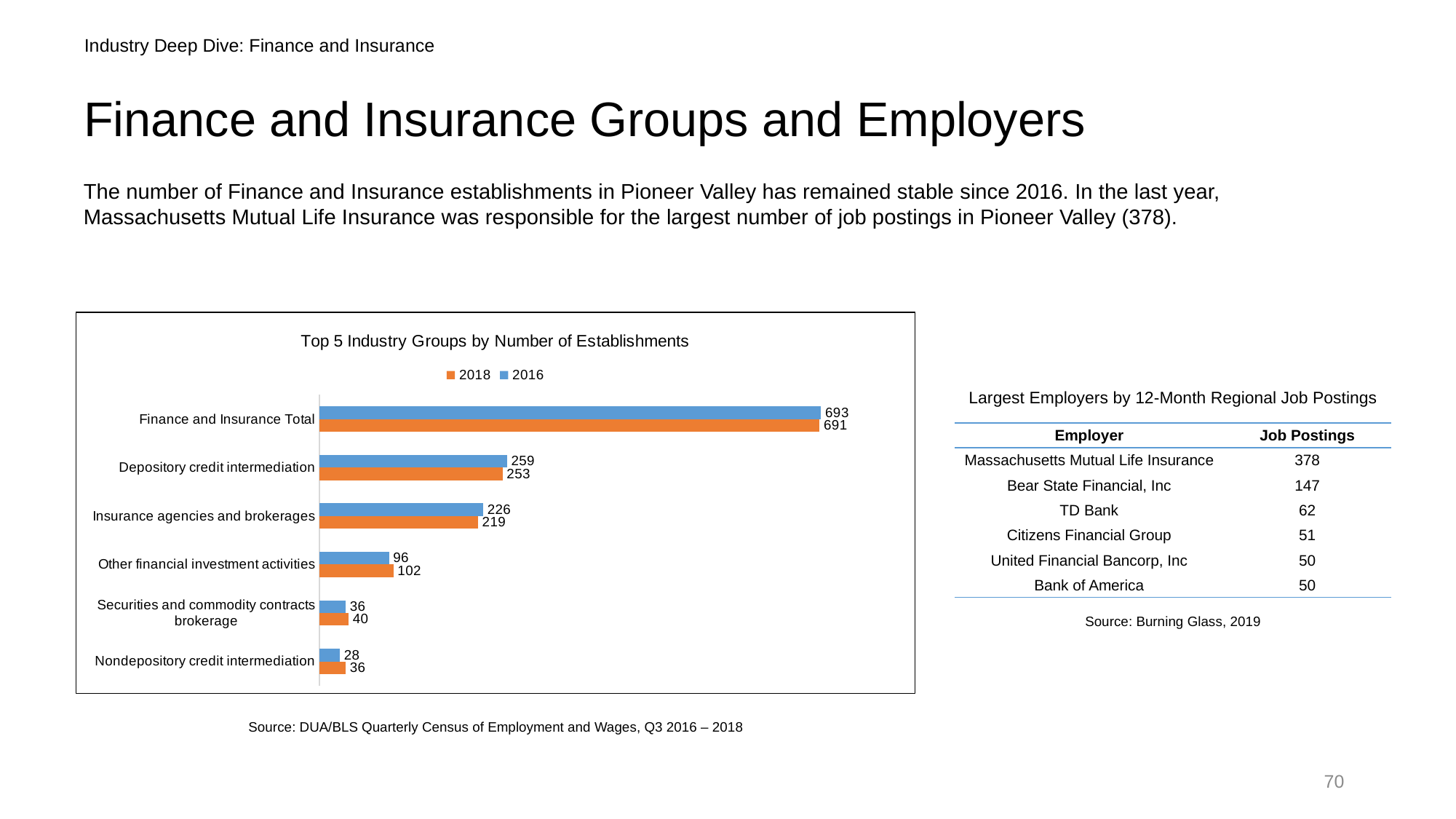
What is the 2016 value for Insurance agencies and brokerages? 226 How many series does the legend of the chart list? 2 Which category has the lowest 2016 value? Nondepository credit intermediation What is the 2016 value for Nondepository credit intermediation? 28 What is the difference between the 2016 and 2018 values for Securities and commodity contracts brokerage? 4 For Other financial investment activities, which year has the larger value, 2016 or 2018? 2018 What is the 2018 value for Other financial investment activities? 102 Excluding the Finance and Insurance Total, which category has the highest 2018 value? Depository credit intermediation How many categories are shown on the chart's vertical axis? 6 Which colour represents the 2018 series in the chart? Orange What is the 2018 value for Depository credit intermediation? 253 What type of chart is 'Top 5 Industry Groups by Number of Establishments'? Bar chart